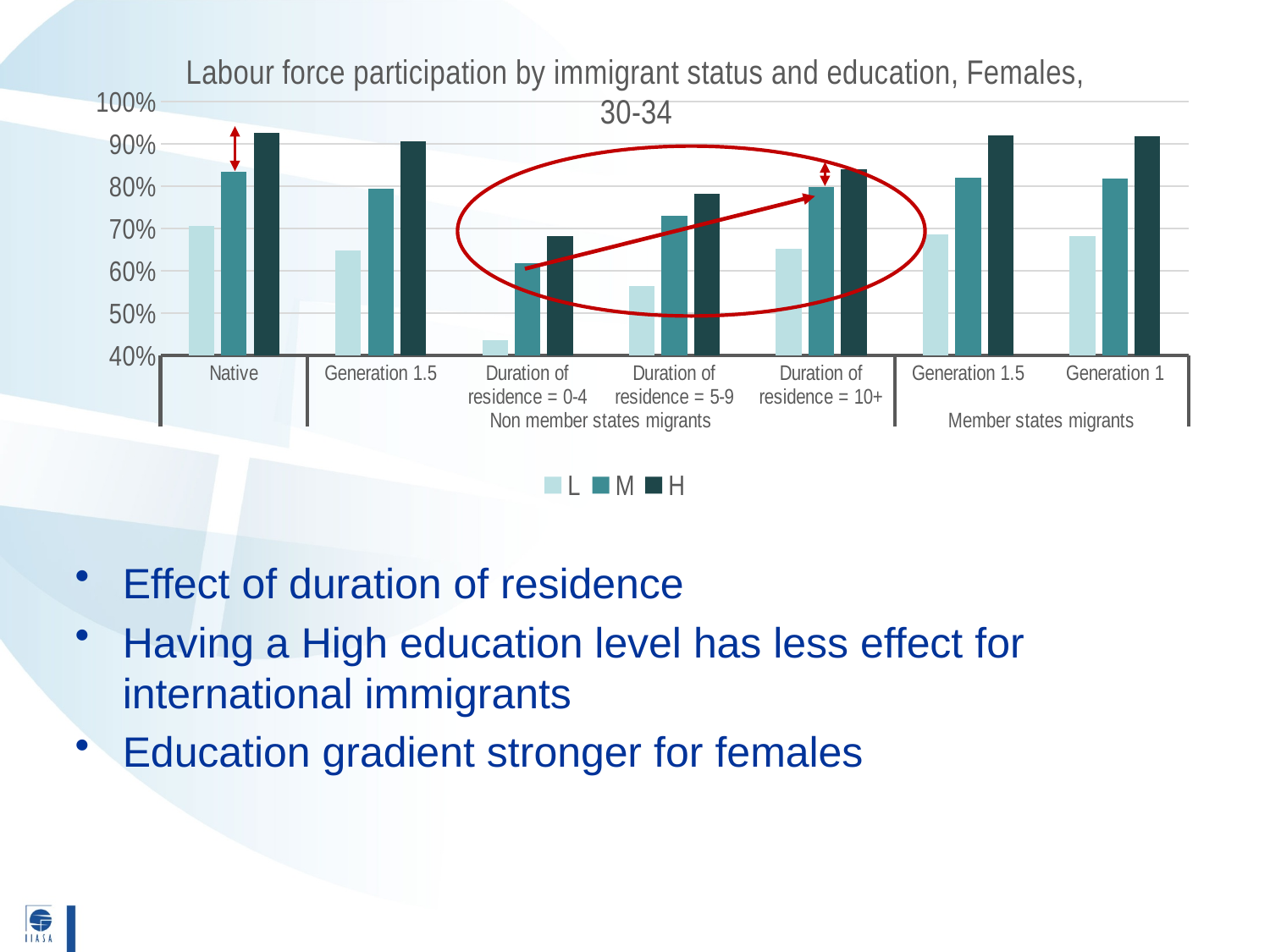
How many categories are shown along the x axis? 7 Is the H value for Native greater or less than 90%? greater What kind of chart is shown on the slide? bar chart Which category has the lowest value for the L series? Duration of residence = 0-4 Which is larger: the L value for Duration of residence = 5-9 or the L value for Duration of residence = 10+? Duration of residence = 10+ Which is larger: the H value for Native or the H value for Duration of residence = 0-4? Native What are the three legend entries of the chart? L, M, H Is the L value for Duration of residence = 0-4 greater or less than 50%? less Among the three duration of residence categories, which has the highest H value? Duration of residence = 10+ Across the three duration of residence categories (0-4, 5-9, 10+), do the H values rise or fall? rise Is the M value for Duration of residence = 5-9 greater or less than 70%? greater How many series does the legend list? 3